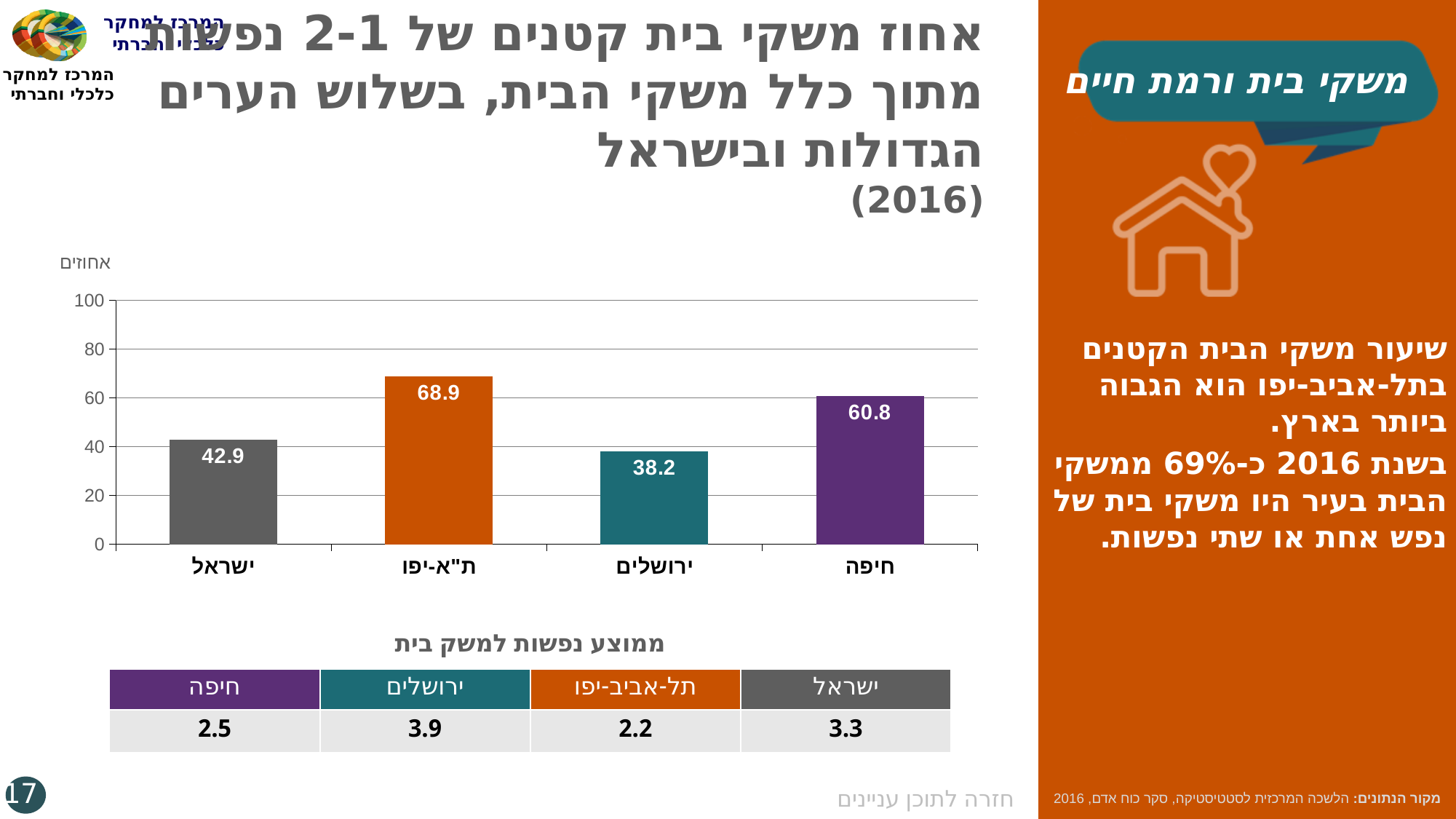
How many categories are shown in the bar chart? 4 Which category has the lowest value in the bar chart? ירושלים What is the value for ירושלים in the bar chart? 38.2 What is the difference between the values for ת"א-יפו and ירושלים? 30.7 What is the label of the vertical axis of the chart? אחוזים What is the difference between the values for חיפה and ישראל? 17.9 What is the value for ת"א-יפו in the bar chart? 68.9 What is the value for ישראל in the bar chart? 42.9 Which is larger, the value for חיפה or the value for ישראל? חיפה What kind of chart is shown on the slide? bar chart Which category has the highest value in the bar chart? ת"א-יפו What is the value for חיפה in the bar chart? 60.8